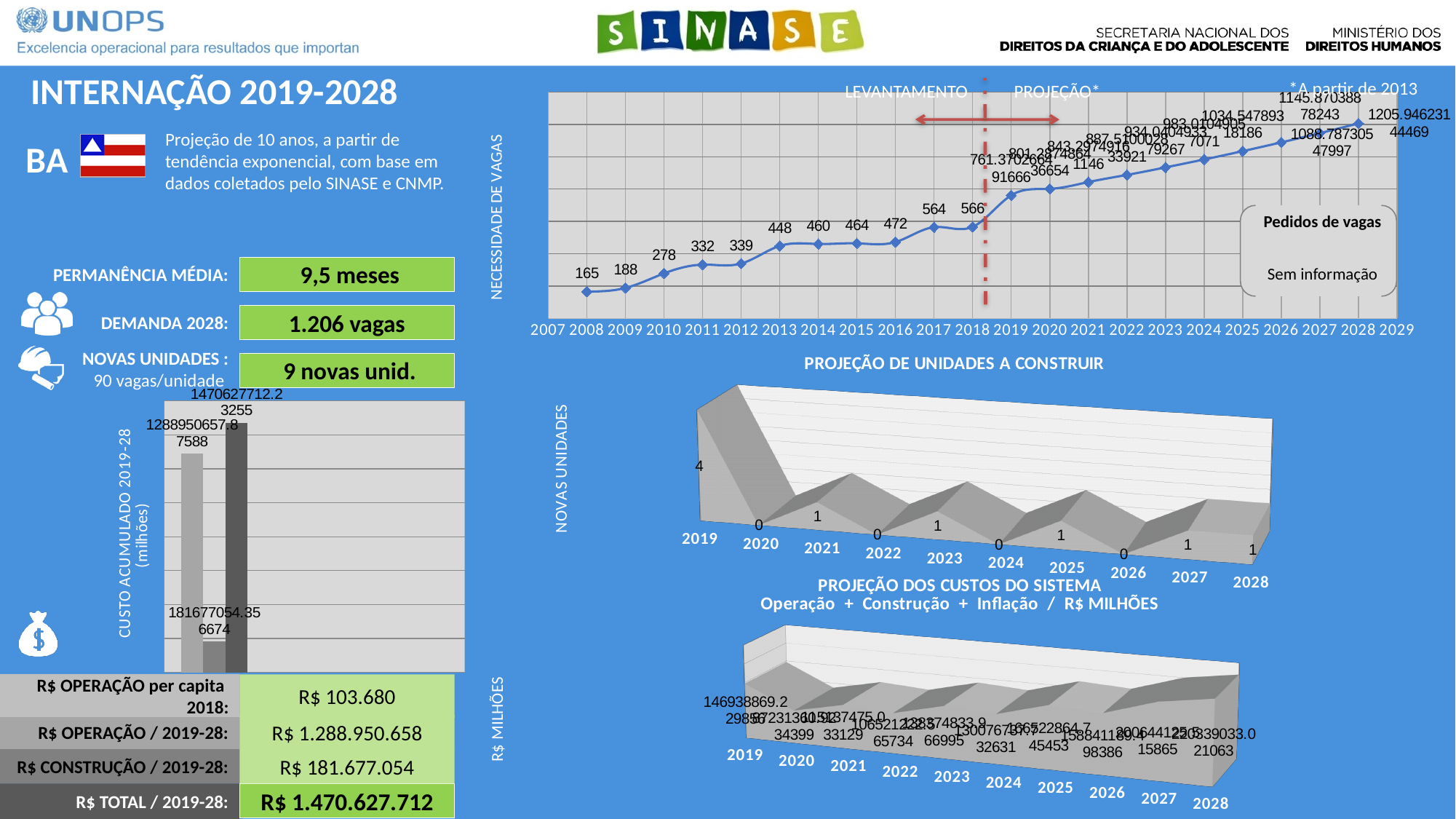
In the NECESSIDADE DE VAGAS line chart, what is the value for 2017? 564 In the PROJEÇÃO DE UNIDADES A CONSTRUIR chart, what is the value for 2019? 4 In the NECESSIDADE DE VAGAS line chart, what is the lowest labelled value? 165 In the NECESSIDADE DE VAGAS chart, do the values generally rise or fall from 2008 to 2028? rise How many bars are in the CUSTO ACUMULADO 2019-28 chart on the left of the slide? 3 In the NECESSIDADE DE VAGAS line chart, what is the value for 2013? 448 In the NECESSIDADE DE VAGAS line chart, which is larger, the value for 2016 or the value for 2015? 2016 In the NECESSIDADE DE VAGAS line chart, what is the difference between the values for 2013 and 2012? 109 In the PROJEÇÃO DE UNIDADES A CONSTRUIR chart, which year has the highest value? 2019 In the NECESSIDADE DE VAGAS line chart, what is the difference between the values for 2018 and 2017? 2 How many years are shown on the x axis of the PROJEÇÃO DE UNIDADES A CONSTRUIR chart? 10 What kind of chart is the NECESSIDADE DE VAGAS chart at the top right? line chart